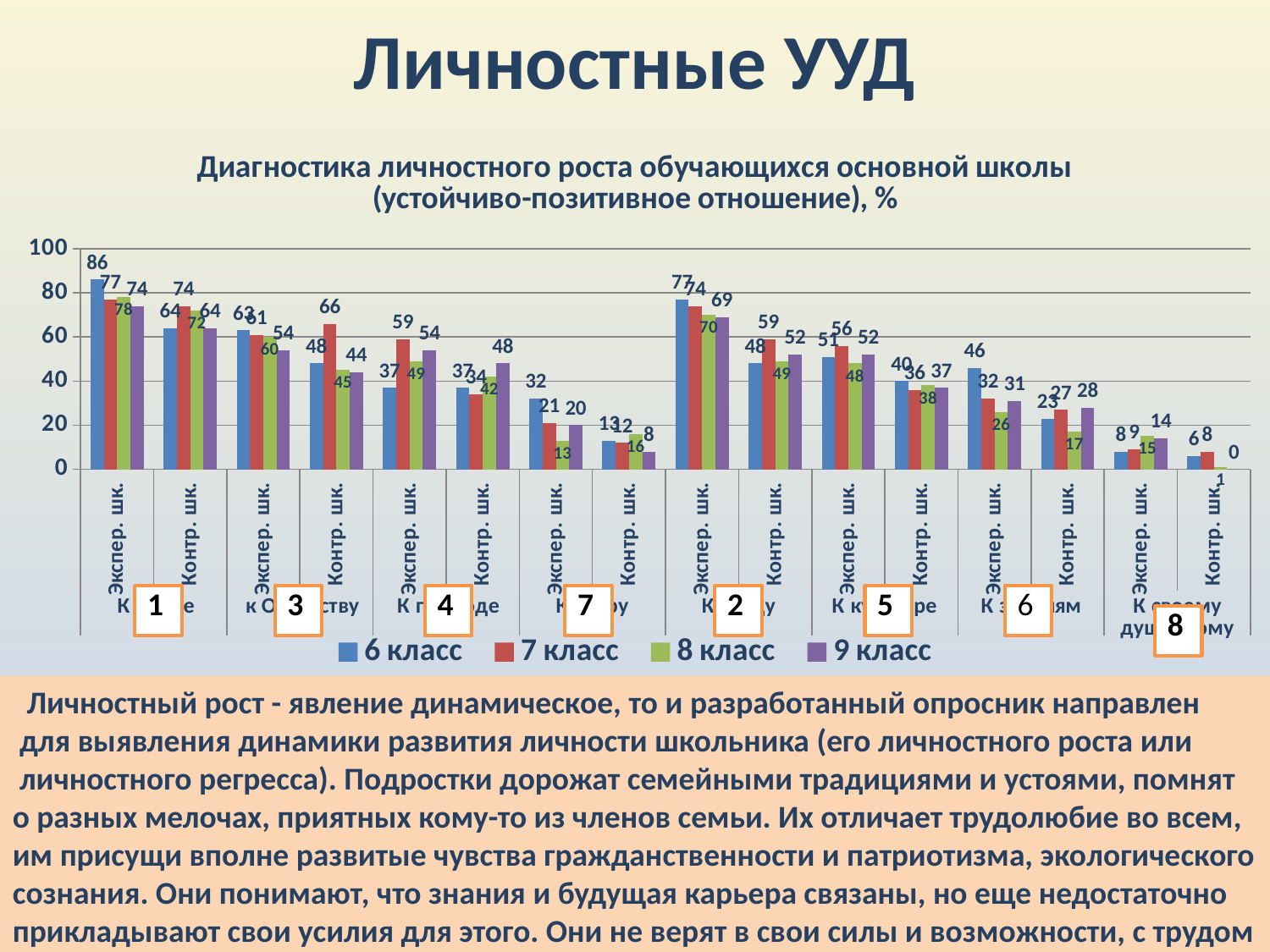
What are the series listed in the chart legend? 6 класс, 7 класс, 8 класс, 9 класс What type of chart is shown on the slide? bar chart In the leftmost Экспер. шк. category, what is the difference between the 6 класс value and the 9 класс value? 12 Is the value for 6 класс in the fifth Экспер. шк. category from the left greater or less than 60? greater What is the value for 9 класс in the rightmost Контр. шк. category? 0 In the leftmost Контр. шк. category, which series has the larger value: 6 класс or 7 класс? 7 класс What is the value for 6 класс in the leftmost Экспер. шк. category? 86 What is the highest value shown on the chart? 86 How many Экспер. шк./Контр. шк. category pairs are shown along the x axis? 8 How many series does the chart legend list? 4 What is the value for 8 класс in the second Контр. шк. category from the left? 45 What is the title of the chart? Диагностика личностного роста обучающихся основной школы (устойчиво-позитивное отношение), %